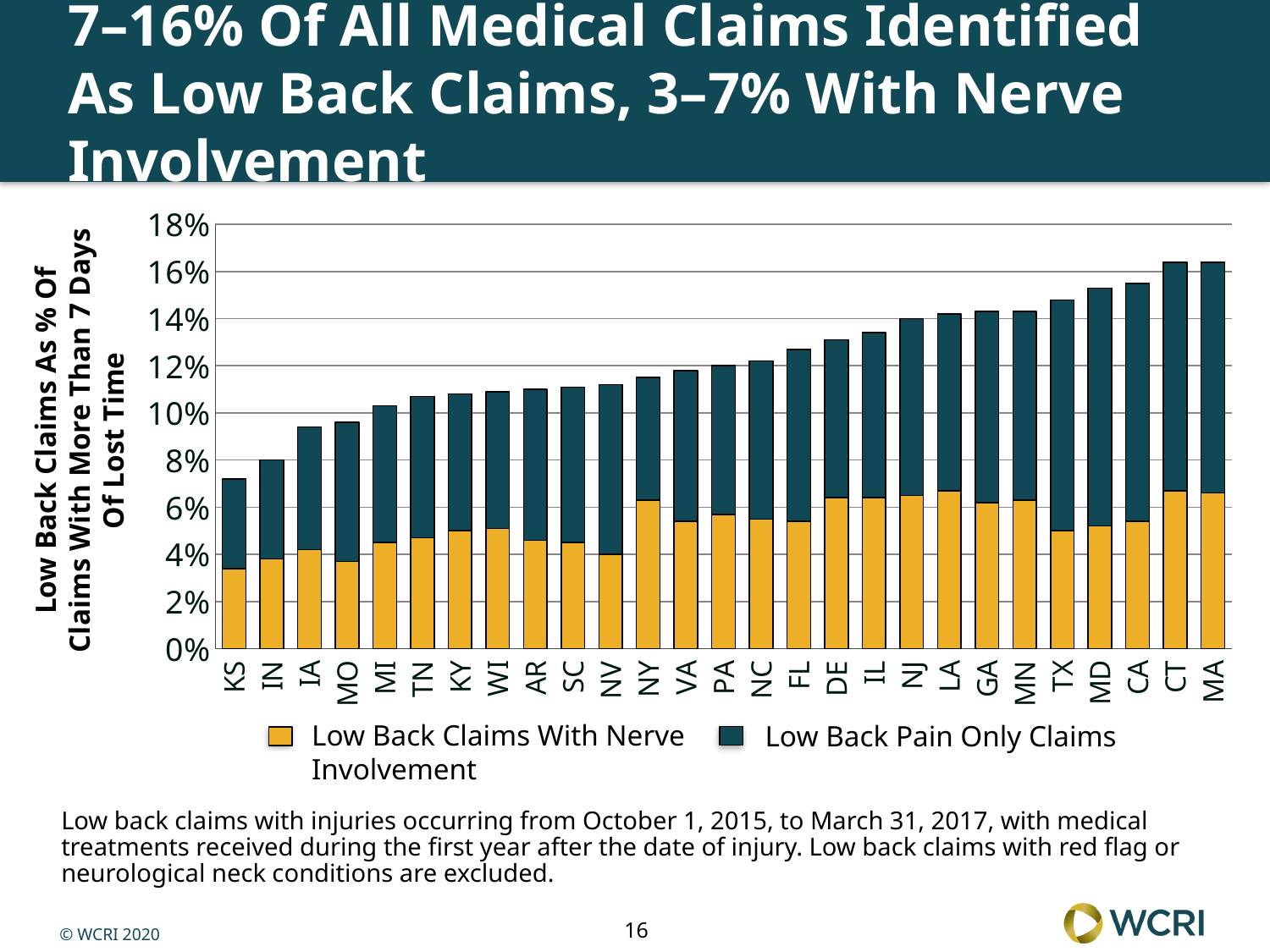
Which series is shown in the yellow/orange colour in the chart? Low Back Claims With Nerve Involvement What kind of chart is shown on the slide? bar chart Is the total value for MA greater or less than 16%? greater Which state has a larger total value, IN or TX? TX How many series does the chart's legend list? 2 Which state has a larger Low Back Claims With Nerve Involvement value, NV or NY? NY Which state has the lowest total share of low back claims? KS How many states are shown along the x axis of the chart? 27 Is the Low Back Claims With Nerve Involvement value for KS greater or less than 4%? less Is the total value for IL greater or less than 12%? greater Do the total bar heights rise or fall moving from left to right along the x axis? rise